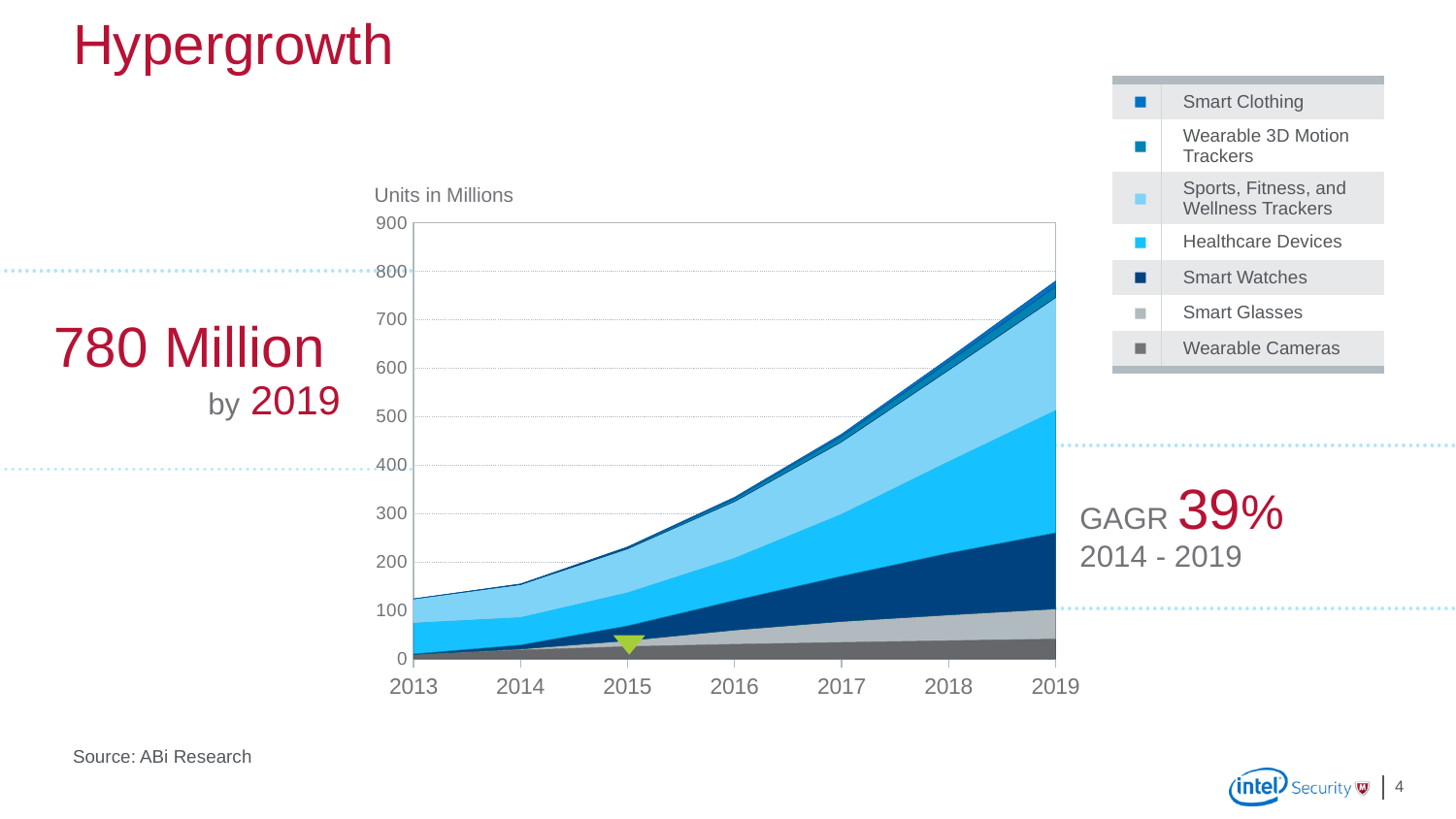
In which year is the total number of units lowest? 2013 How many series does the chart's legend list? 7 According to the slide, how many units are forecast by 2019? 780 Million What is the source cited for the chart? ABi Research Is the total value for 2013 greater or less than 200? less Is the total value for 2016 greater or less than 400? less What kind of chart is shown on the slide? stacked area chart How many years are shown along the x axis of the chart? 7 Is the total value for 2018 greater or less than 500? greater In which year is the total number of units highest? 2019 Do the total units rise or fall from 2013 to 2019? rise What unit is used for the chart's y axis? Units in Millions